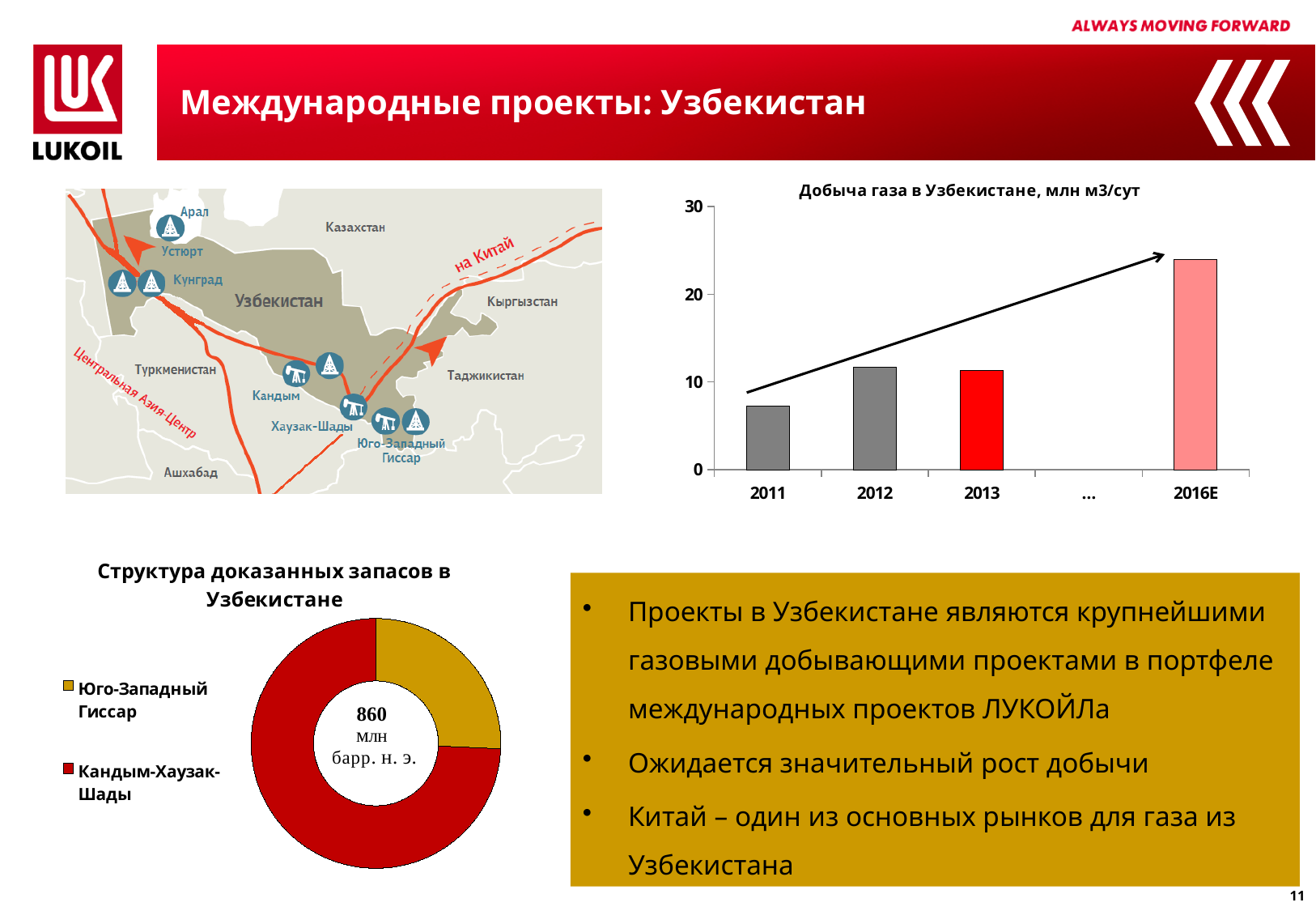
What type of chart is 'Структура доказанных запасов в Узбекистане'? doughnut chart In the chart 'Добыча газа в Узбекистане, млн м3/сут', which year has the highest value? 2016E What type of chart is 'Добыча газа в Узбекистане, млн м3/сут'? bar chart In the chart 'Добыча газа в Узбекистане, млн м3/сут', is the value for 2011 greater or less than 10? less In the chart 'Добыча газа в Узбекистане, млн м3/сут', do the values overall rise or fall from 2011 to 2016E? rise How many entries does the legend of the chart 'Структура доказанных запасов в Узбекистане' list? 2 In the chart 'Добыча газа в Узбекистане, млн м3/сут', which year has the lowest value? 2011 In the chart 'Добыча газа в Узбекистане, млн м3/сут', which is larger, the value for 2011 or the value for 2016E? 2016E In the chart 'Структура доказанных запасов в Узбекистане', which category has the larger share? Кандым-Хаузак-Шады In the chart 'Добыча газа в Узбекистане, млн м3/сут', is the value for 2016E greater or less than 20? greater In the chart 'Добыча газа в Узбекистане, млн м3/сут', is the value for 2012 greater or less than 10? greater What is the highest value shown on the vertical axis of the chart 'Добыча газа в Узбекистане, млн м3/сут'? 30